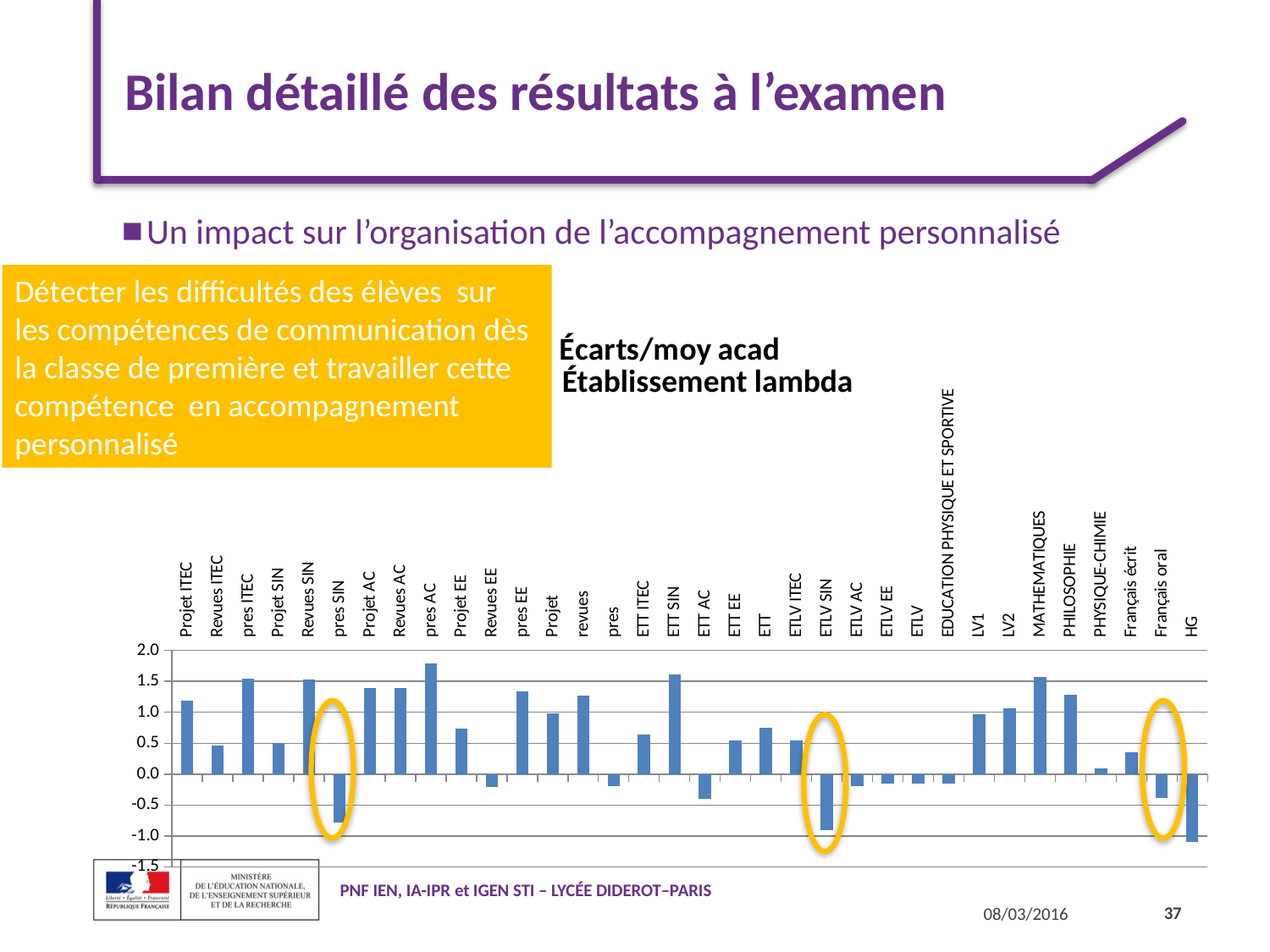
Which is larger, the value for pres ITEC or the value for Revues ITEC? pres ITEC Is the value for Projet ITEC greater or less than 1.0? greater Which category has the lowest value in the chart? HG Is the value for ETLV SIN greater or less than -0.5? less What is the title of the chart? Écarts/moy acad Établissement lambda What kind of chart is shown on the slide? bar chart Which is larger, the value for Français écrit or the value for Français oral? Français écrit Which category has the highest value in the chart? pres AC Is the value for pres SIN greater or less than -0.5? less How many categories are plotted on the x axis of the chart? 34